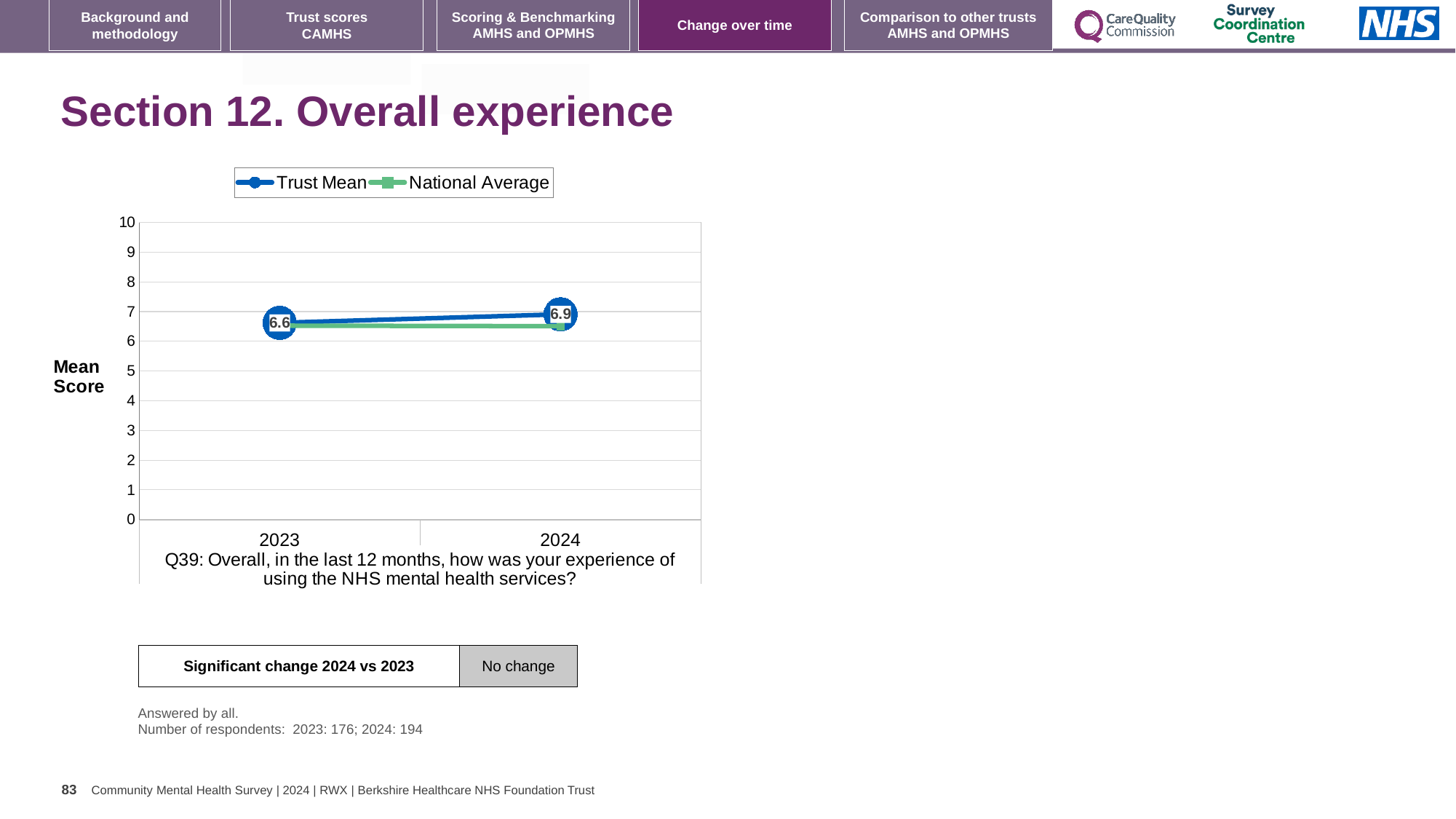
How many years are plotted on the x axis? 2 Which year has the higher Trust Mean score, 2023 or 2024? 2024 Is the National Average value for 2024 greater or less than 7? less Does the Trust Mean line rise or fall from 2023 to 2024? rise What is the Trust Mean score for 2023? 6.6 What is the label on the y axis of the chart? Mean Score What kind of chart is shown on the slide? line chart What is the Trust Mean score for 2024? 6.9 In 2024, which is higher, the Trust Mean or the National Average? Trust Mean By how much did the Trust Mean score change from 2023 to 2024? 0.3 How many series does the legend list? 2 Is the National Average value for 2023 greater or less than 5? greater